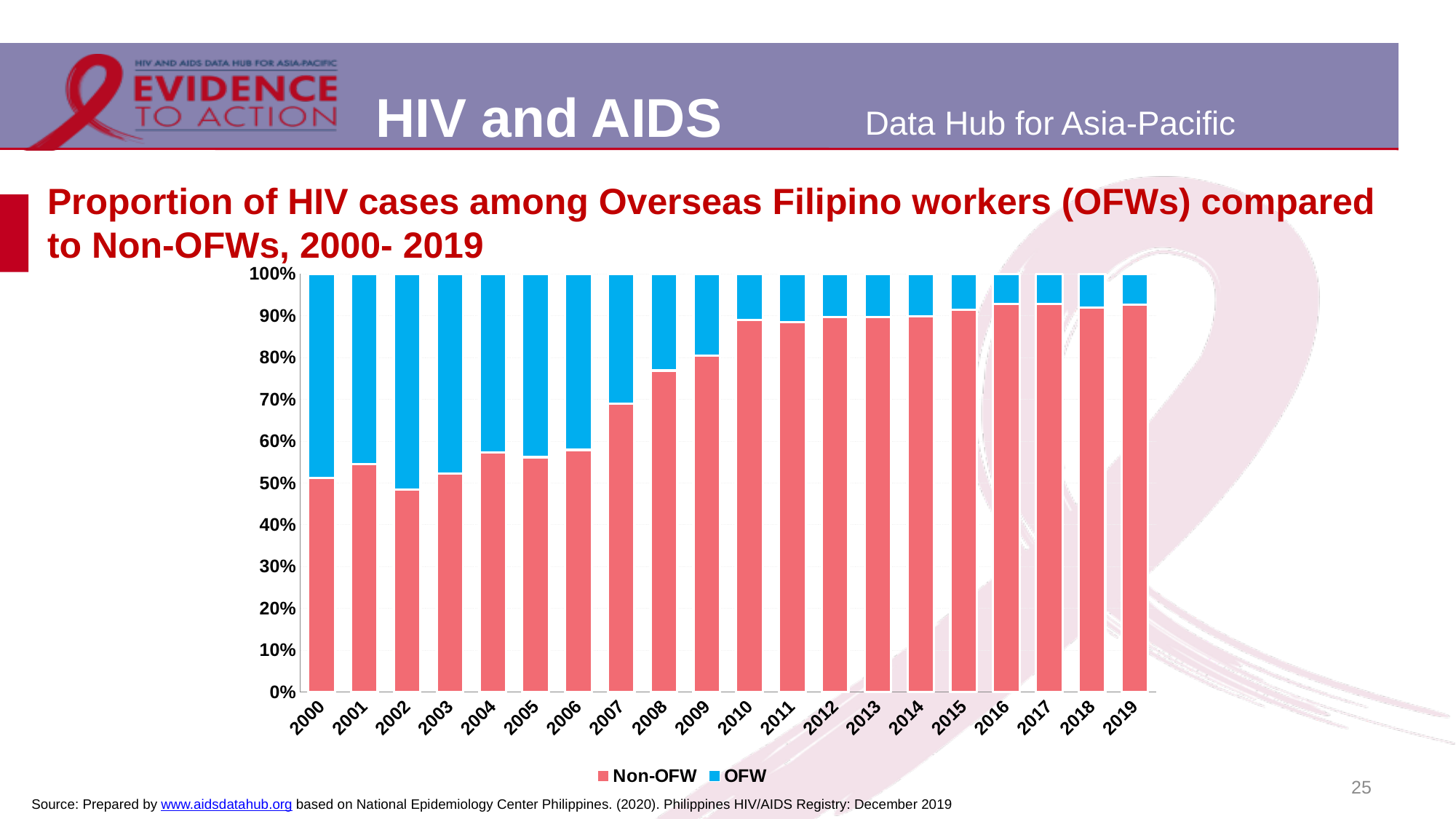
Which series is shown in blue in the chart? OFW Is the Non-OFW share in 2004 greater or less than 60%? less What is the total of the stacked bar for 2010? 100% What type of chart is shown on the slide? Stacked bar chart Does the OFW share generally rise or fall from 2000 to 2019? Fall Which year has a larger Non-OFW share, 2000 or 2008? 2008 How many series does the chart legend list? 2 Is the Non-OFW share in 2008 greater or less than 70%? greater In which year is the OFW share the highest? 2002 Does the Non-OFW share generally rise or fall from 2000 to 2019? Rise In which year is the Non-OFW share the lowest? 2002 How many years are shown on the x axis of the chart? 20